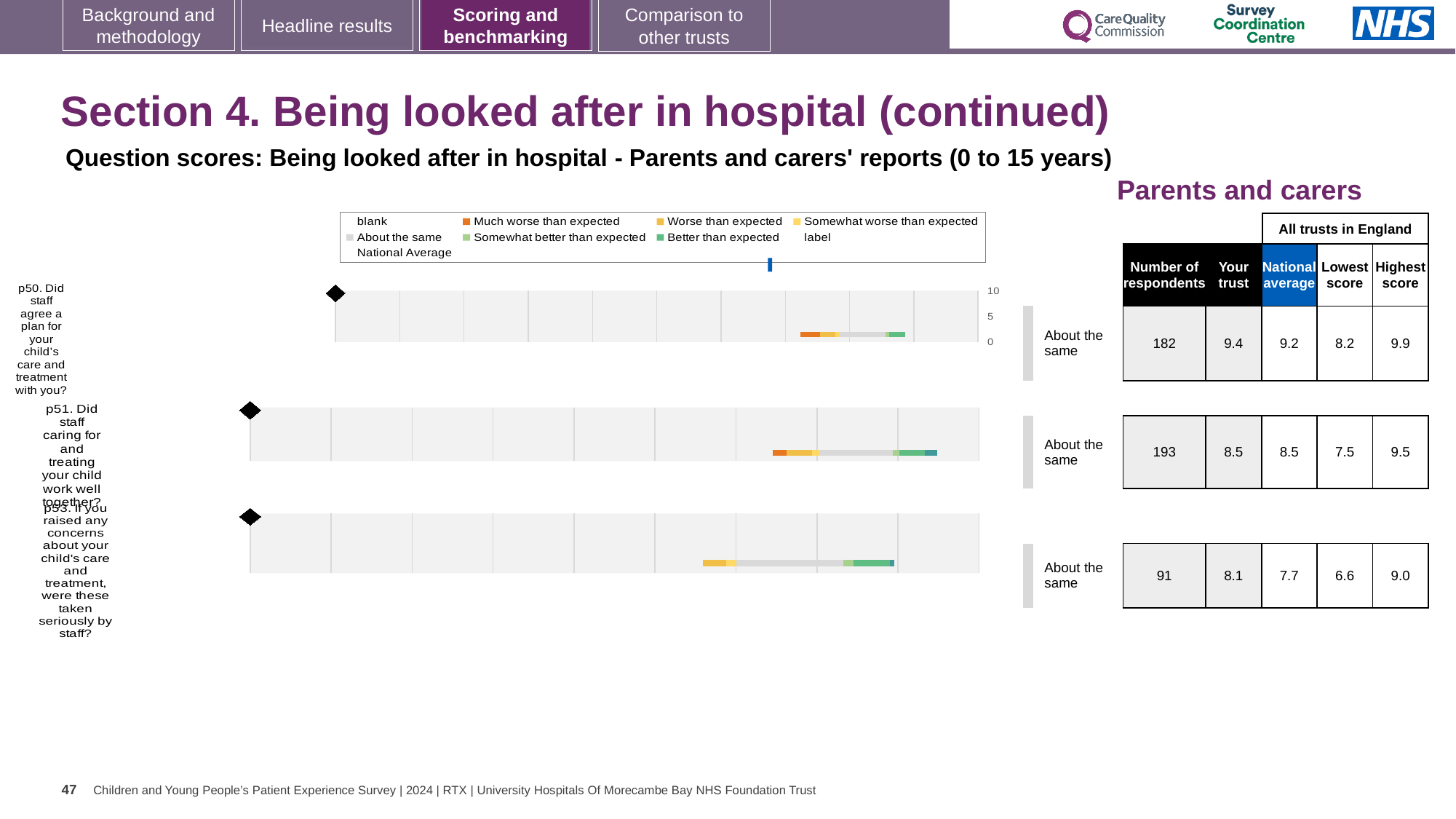
What is the 'Your trust' score for p50 (Did staff agree a plan for your child's care and treatment with you?)? 9.4 How many respondents answered p51 (Did staff caring for and treating your child work well together?)? 193 What kind of chart is used to show the question scores on this slide? bar chart What benchmark category is shown next to the chart for p51? About the same For p53, which is larger: the 'Your trust' score or the national average? Your trust How many survey questions (p50, p51, p53) are plotted on the slide? 3 What is the national average score for p53 (If you raised any concerns about your child's care and treatment, were these taken seriously by staff?)? 7.7 For p53, what is the difference between the highest score and the lowest score across all trusts in England? 2.4 Which of the three questions has the highest 'Your trust' score? p50 For p50, what is the difference between the 'Your trust' score and the national average? 0.2 What is the highest score across all trusts in England for p50? 9.9 Which of the three questions has the lowest number of respondents? p53